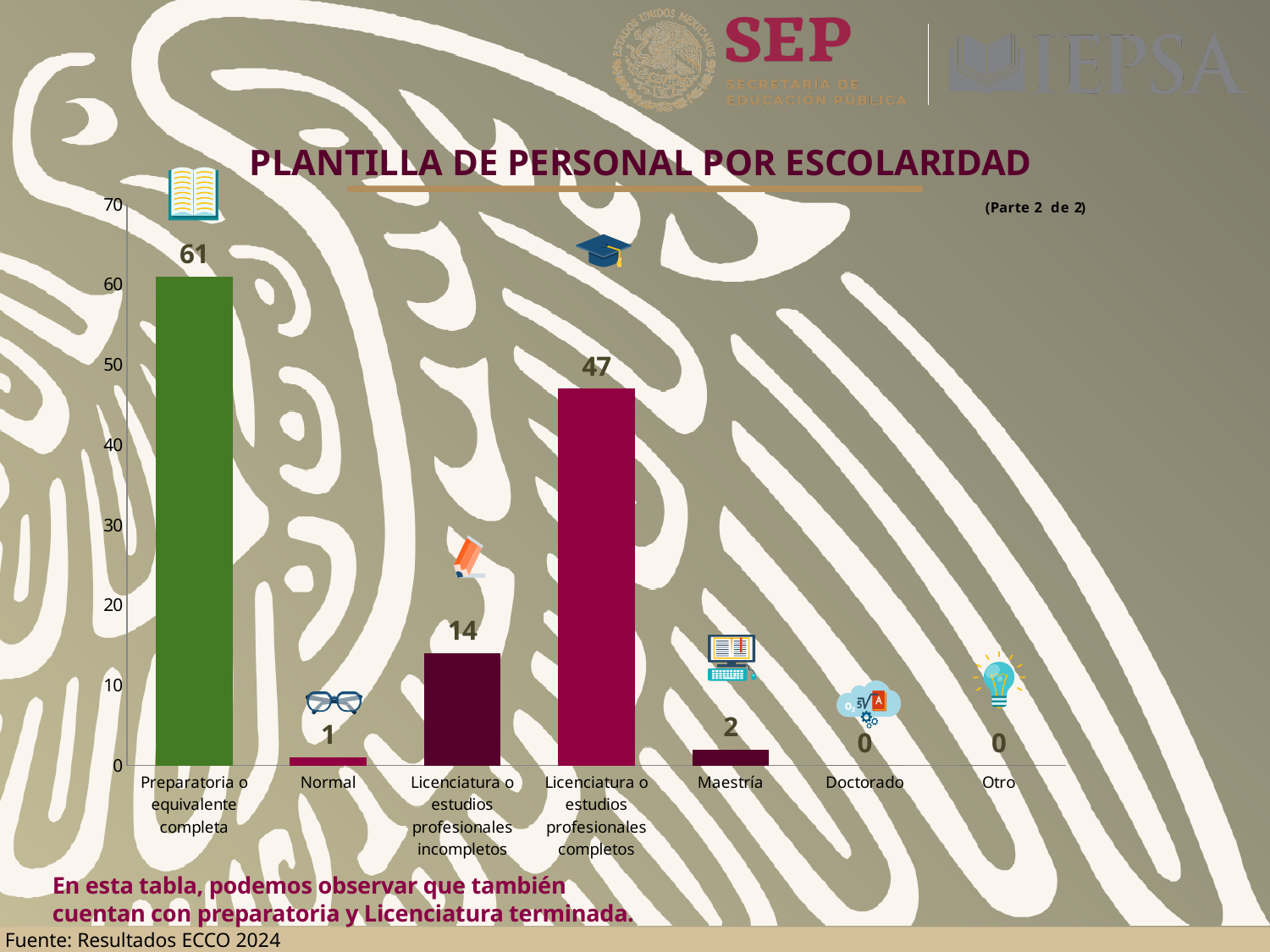
What is the value for Doctorado? 0 What kind of chart is shown on the slide? bar chart Which category has the highest value? Preparatoria o equivalente completa What is the value for Maestría? 2 What is the title of the chart? PLANTILLA DE PERSONAL POR ESCOLARIDAD What is the value for Licenciatura o estudios profesionales completos? 47 What is the value for Preparatoria o equivalente completa? 61 Is the value for Licenciatura o estudios profesionales completos greater or less than 40? greater Which is larger, the value for Normal or the value for Maestría? Maestría How many categories are shown on the x axis? 7 What is the value for Licenciatura o estudios profesionales incompletos? 14 What is the difference between the values for Preparatoria o equivalente completa and Licenciatura o estudios profesionales completos? 14